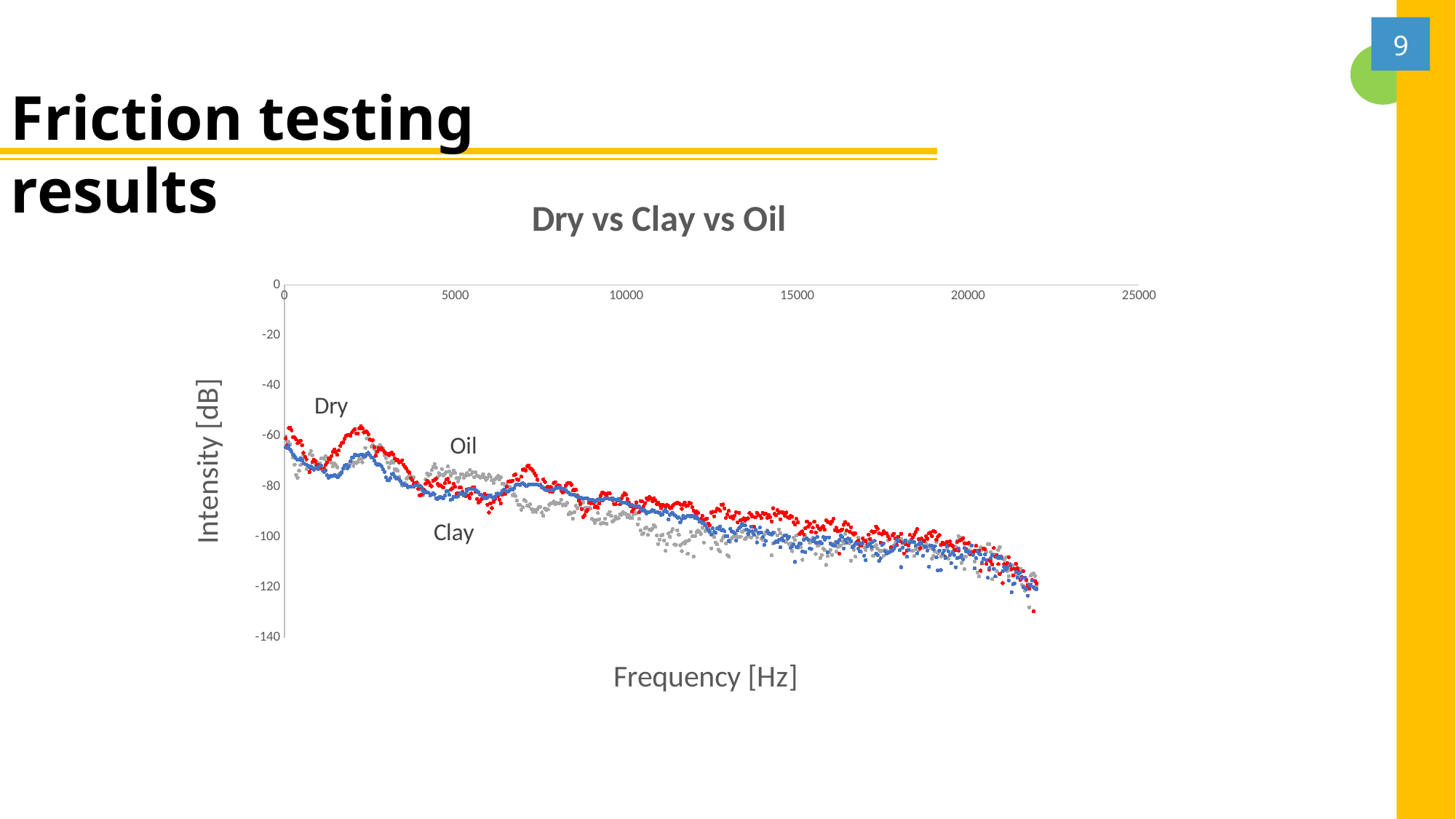
Do the intensity values generally rise or fall as frequency increases along the x axis? Fall What kind of chart is shown on the slide? Scatter chart What is the title of the chart? Dry vs Clay vs Oil Is the intensity of the Dry series at about 15000 Hz greater or less than -80 dB? less What is the largest value shown on the frequency (x) axis? 25000 How many data series are plotted in the chart? 3 Is the intensity of the Clay series at about 5000 Hz greater or less than -60 dB? less What is the label of the vertical axis of the chart? Intensity [dB]